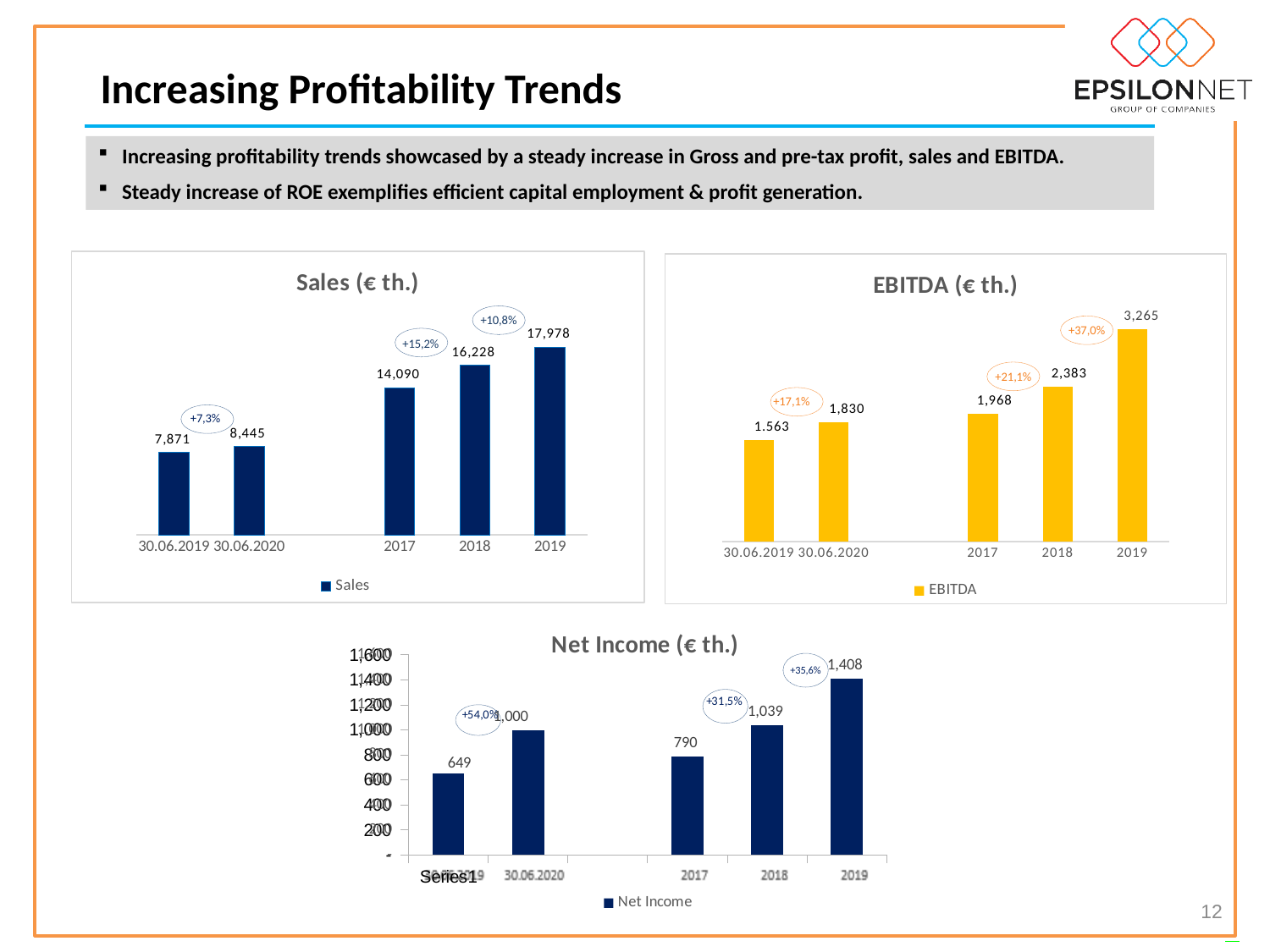
What kind of chart is the Net Income (€ th.) chart? bar chart How many categories are shown on the x axis of the Sales (€ th.) chart? 5 In the Sales (€ th.) chart, what is the value for 2019? 17,978 In the Net Income (€ th.) chart, what is the difference between the 2019 and 2018 values? 369 In the EBITDA (€ th.) chart, which is larger, the value for 30.06.2020 or the value for 2017? 2017 In the EBITDA (€ th.) chart, which category has the highest value? 2019 In the Net Income (€ th.) chart, which category has the lowest value? 30.06.2019 In the Sales (€ th.) chart, what is the difference between the 2019 and 2018 values? 1,750 In the Sales (€ th.) chart, what is the value for 30.06.2020? 8,445 In the EBITDA (€ th.) chart, do the values rise or fall from 2017 to 2019? rise In the Net Income (€ th.) chart, what is the value for 2017? 790 In the EBITDA (€ th.) chart, what is the value for 2018? 2,383